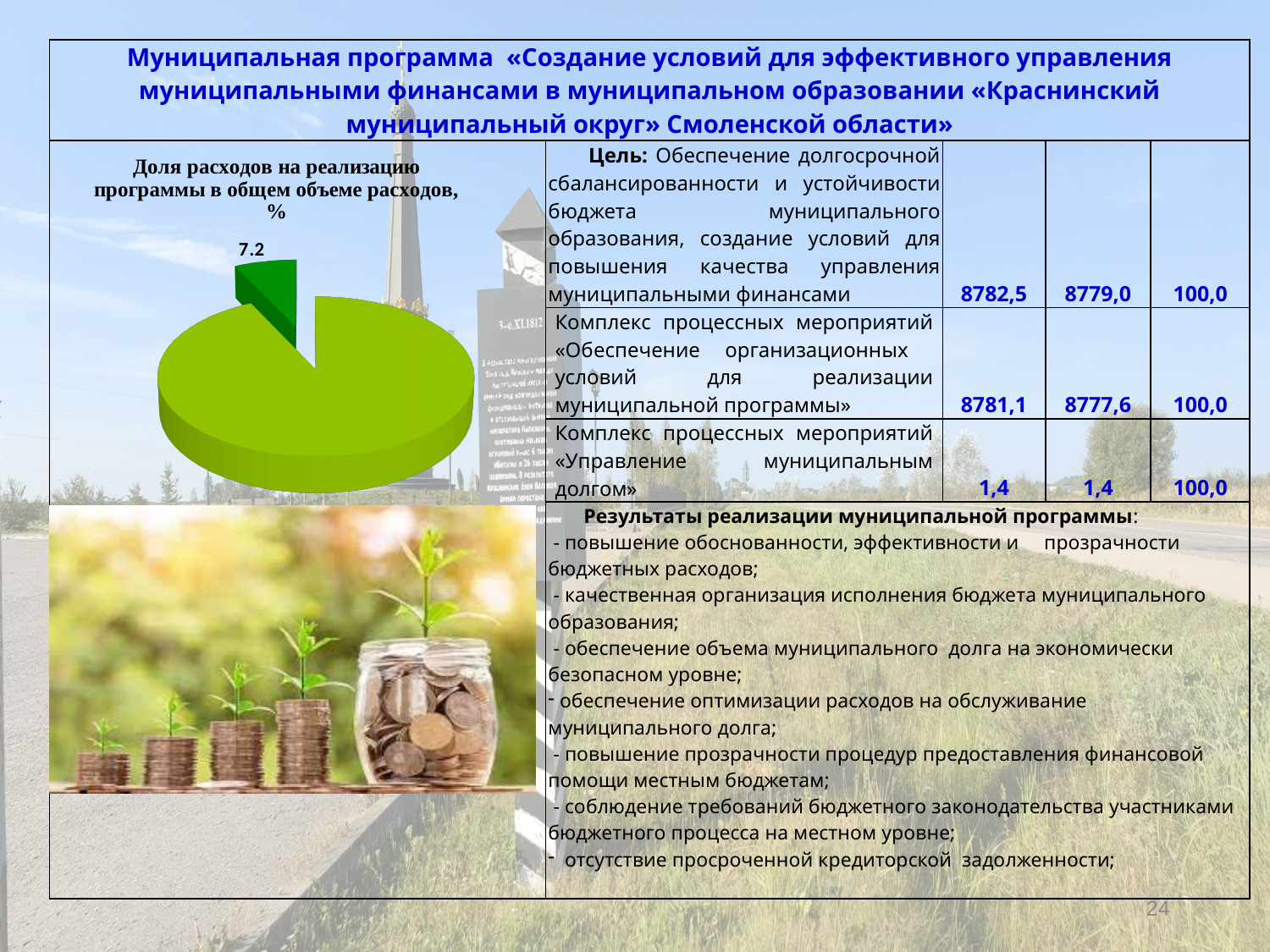
What colour is the slice labelled 7.2 in the pie chart? dark green What value is printed on the labelled slice of the pie chart? 7.2 What share of total expenditure does the labelled slice of the pie chart represent? 7.2% Which slice of the pie chart is the smallest? the dark green slice labelled 7.2 What kind of chart is shown on the left of the slide? pie chart How many slices does the pie chart have? 2 What is the title of the pie chart on the slide? Доля расходов на реализацию программы в общем объеме расходов, % Which slice of the pie chart is larger, the dark green slice labelled 7.2 or the light green slice? the light green slice